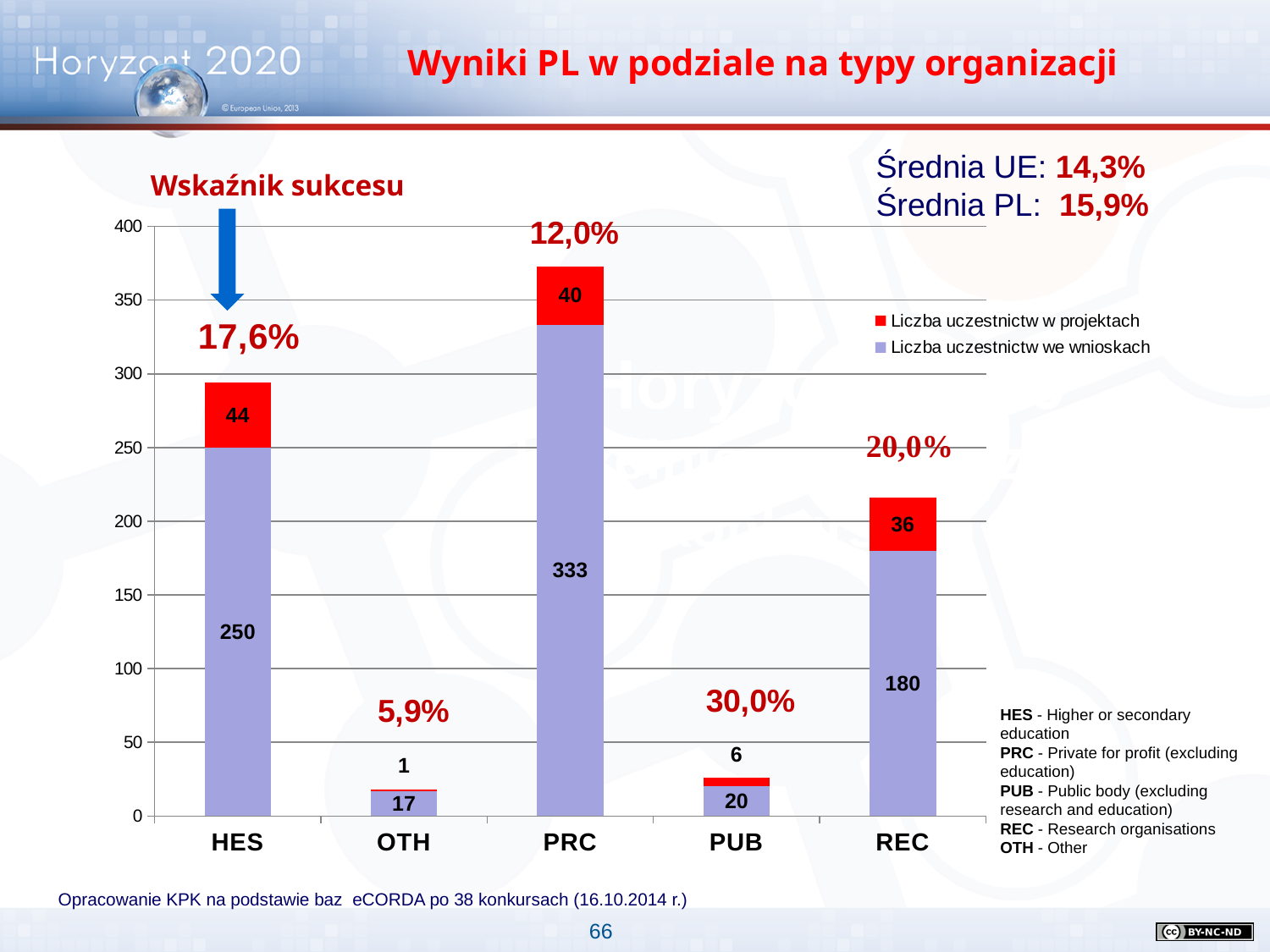
What is the value of 'Liczba uczestnictw w projektach' for HES? 44 What is the difference between 'Liczba uczestnictw we wnioskach' for PRC and for HES? 83 What is the value of 'Liczba uczestnictw w projektach' for REC? 36 Which is larger: 'Liczba uczestnictw w projektach' for HES or for PRC? HES What is the value of 'Liczba uczestnictw we wnioskach' for PRC? 333 What is the total of the stacked bar for HES? 294 How many categories are shown on the x axis of the chart? 5 Which category has the lowest value for 'Liczba uczestnictw w projektach'? OTH What type of chart is shown on the slide? Stacked bar chart Which category has the highest value for 'Liczba uczestnictw we wnioskach'? PRC What success rate (Wskaźnik sukcesu) is shown above the PUB bar? 30,0% How many series does the chart legend list? 2